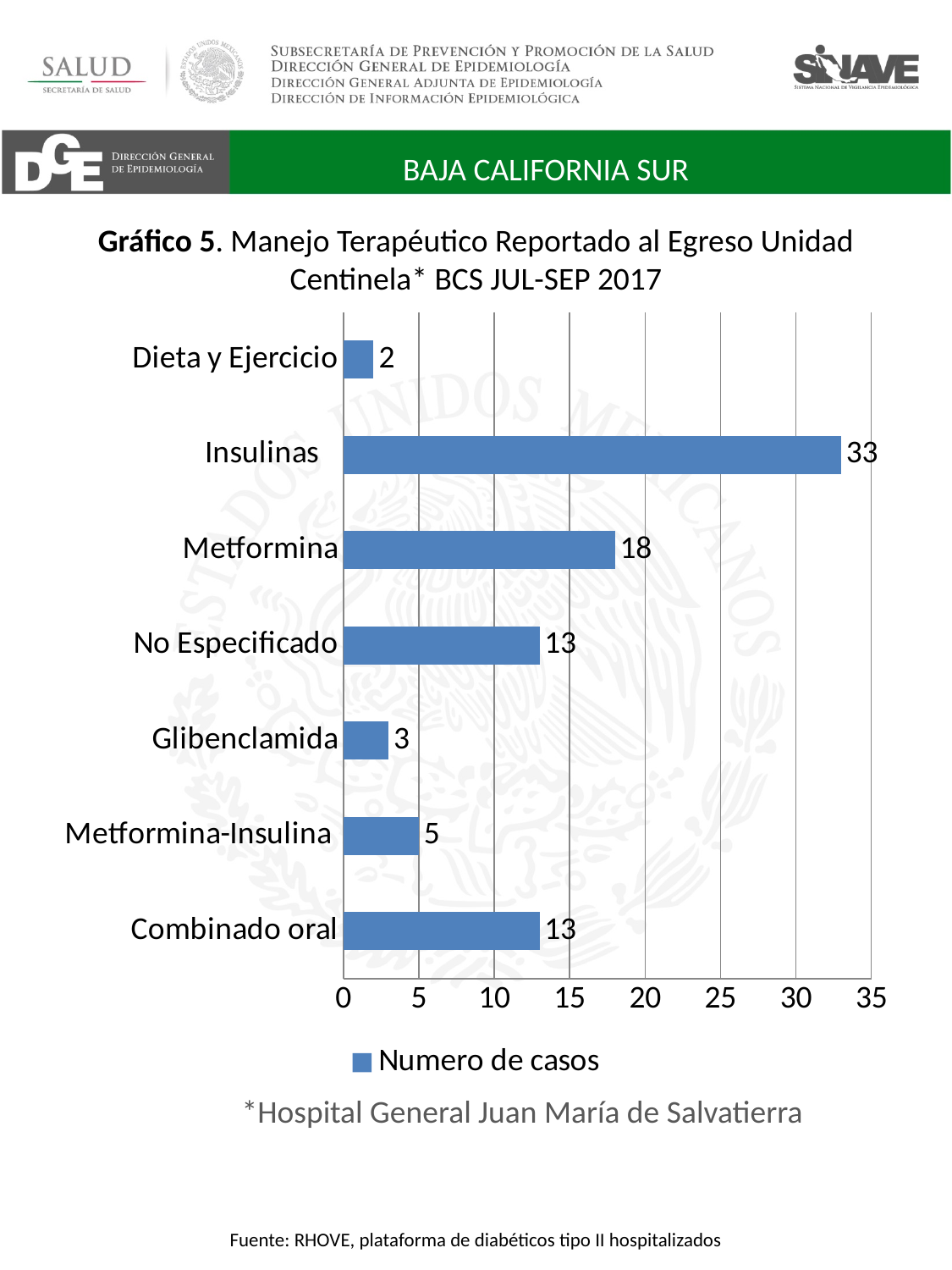
What is the legend entry for the series in the chart? Numero de casos What is the number of cases for Metformina-Insulina? 5 Which category has the lowest number of cases? Dieta y Ejercicio Which category has the highest number of cases? Insulinas What is the number of cases for Insulinas? 33 How many categories are shown in the chart? 7 Which has more cases, Glibenclamida or Metformina-Insulina? Metformina-Insulina What kind of chart is shown on the slide? Bar chart What is the difference in number of cases between Insulinas and Metformina? 15 What is the number of cases for Metformina? 18 What is the number of cases for Dieta y Ejercicio? 2 How many series does the legend list? 1